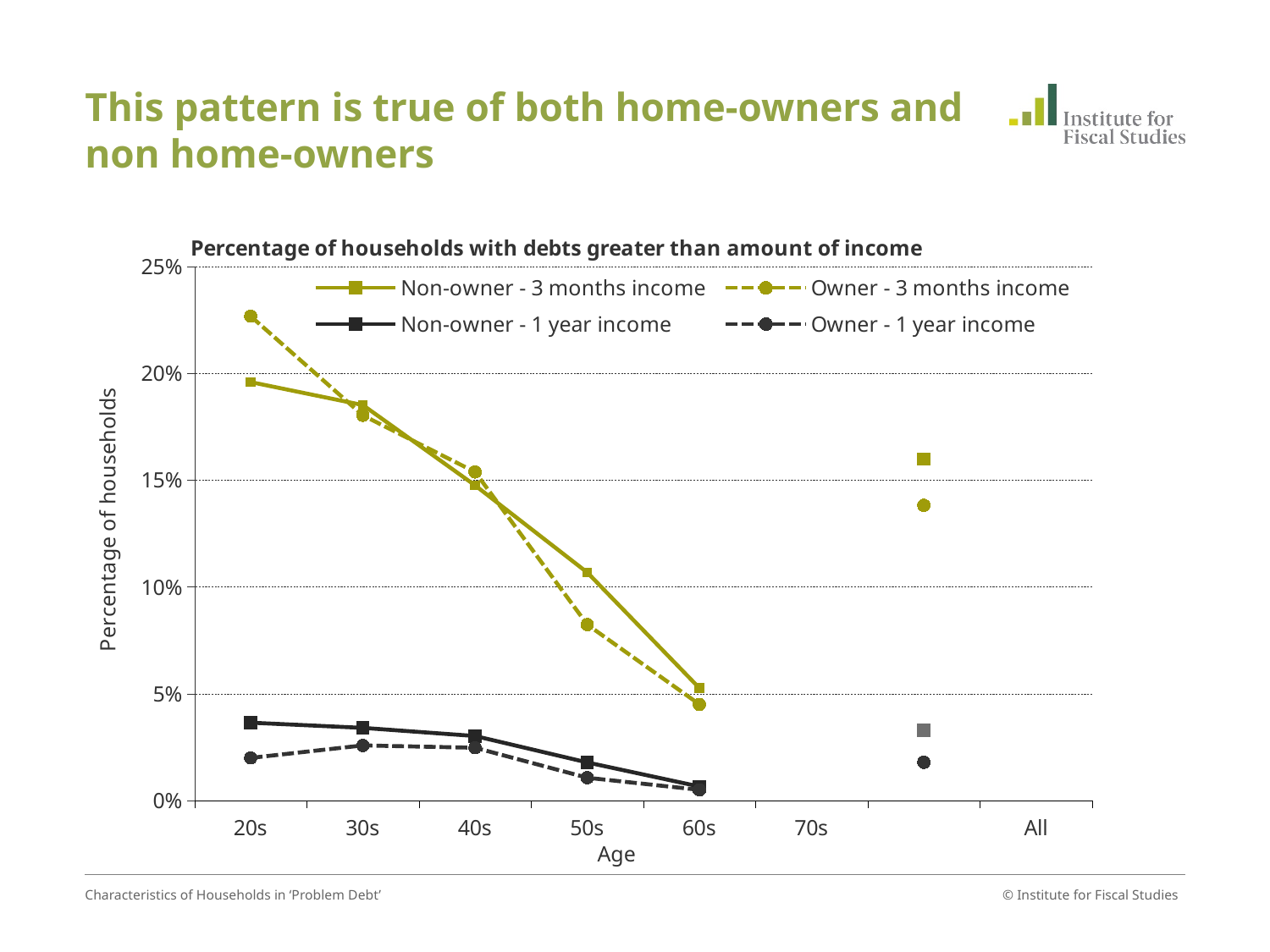
What kind of chart is shown on the slide? line chart Does the 'Non-owner - 3 months income' series rise or fall from 20s to 60s? fall What is the title of the chart? Percentage of households with debts greater than amount of income How many series does the chart's legend list? 4 Is the value for 'Non-owner - 1 year income' at 20s greater or less than 5%? less Is the value for 'Non-owner - 3 months income' at 20s greater or less than 15%? greater Is the value for 'Owner - 3 months income' at 50s greater or less than 10%? less At 50s, which is higher: 'Non-owner - 3 months income' or 'Owner - 3 months income'? Non-owner - 3 months income What is the label on the chart's vertical axis? Percentage of households At 20s, which is higher: 'Owner - 3 months income' or 'Non-owner - 3 months income'? Owner - 3 months income How many category labels appear along the x axis of the chart? 7